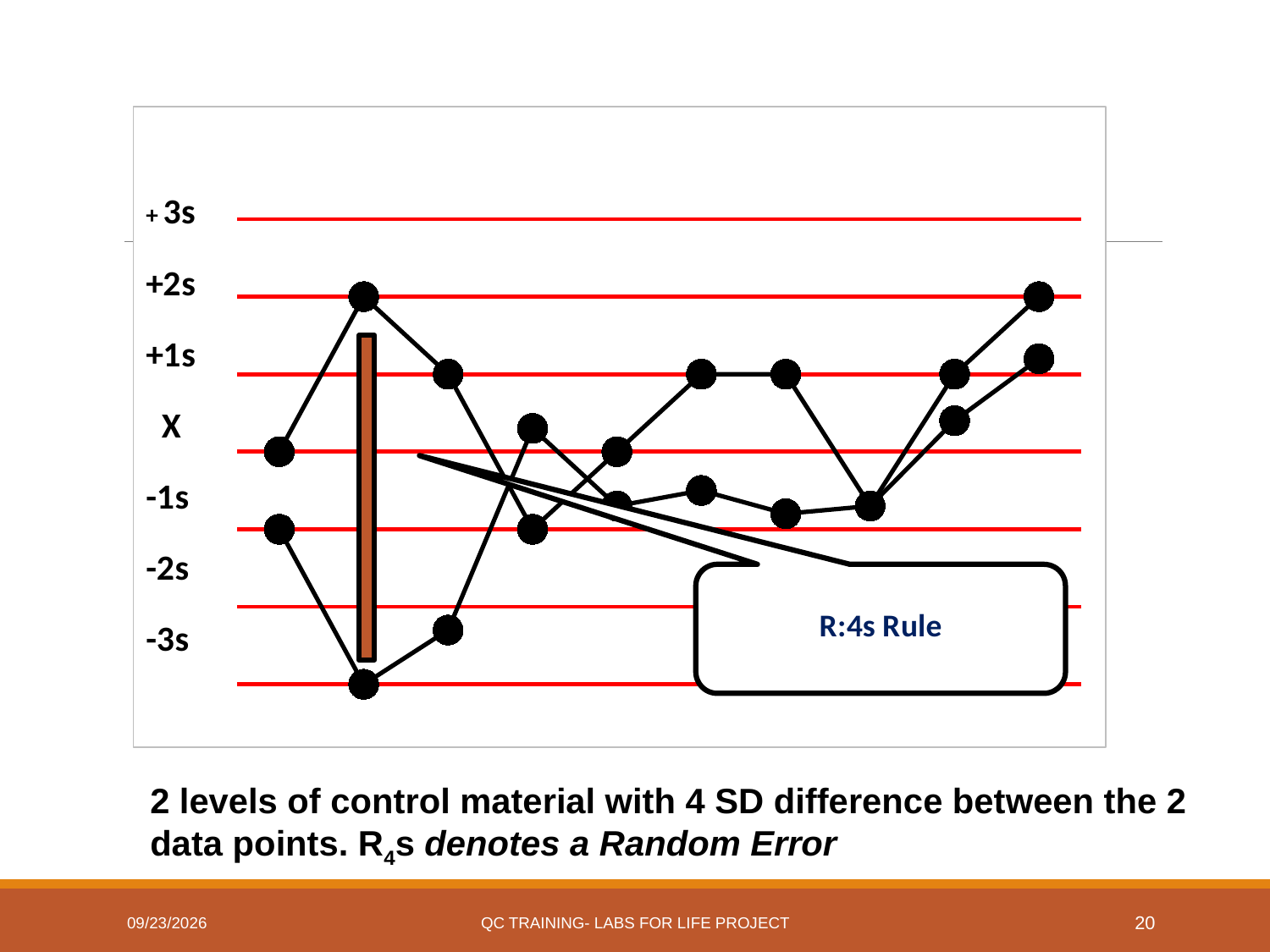
What text appears in the callout box on the chart? R:4s Rule On which labelled control line does the lowest plotted point of the chart lie? -3s On which labelled control line does the highest plotted point of the chart lie? +2s How many horizontal red control-limit lines are drawn on the chart? 7 Over the last three points, do both series rise or fall? rise What kind of chart is shown on the slide? line chart Is the last point of the upper series greater or less than +1s? greater What is the label of the topmost control line on the y axis? +3s Is the lowest plotted point greater or less than -2s? less Is the highest plotted point greater or less than +1s? greater